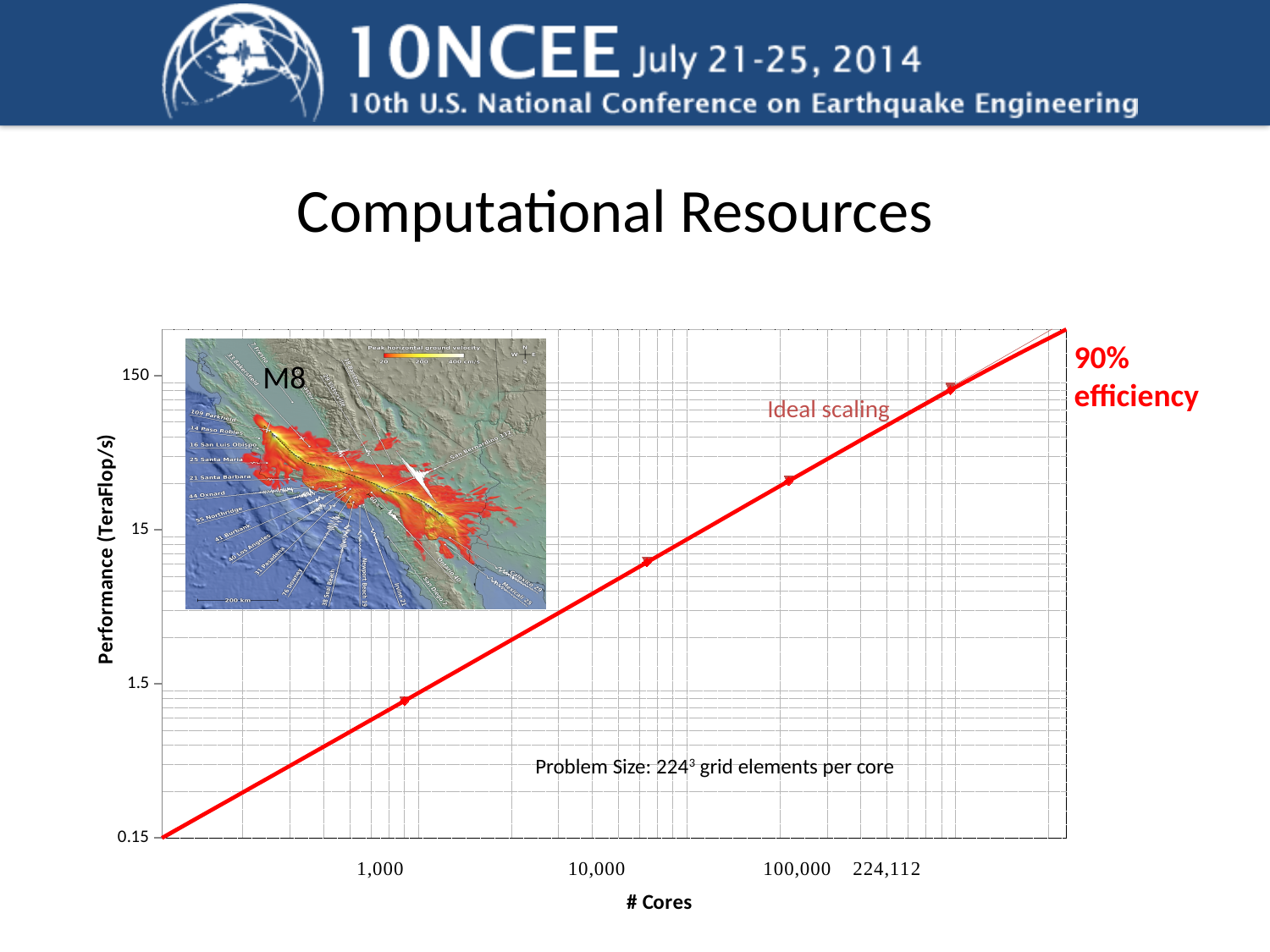
Is the performance value at 100,000 cores greater or less than 15 TeraFlop/s? greater What kind of chart is shown on the slide? line chart Is the performance value at about 1,000 cores greater or less than 0.15 TeraFlop/s? greater Does performance rise or fall as the number of cores increases along the x axis? rise What efficiency is annotated next to the top of the scaling line? 90% efficiency What is the label of the y axis of the chart? Performance (TeraFlop/s) Is the performance value at about 1,000 cores greater or less than 1.5 TeraFlop/s? less